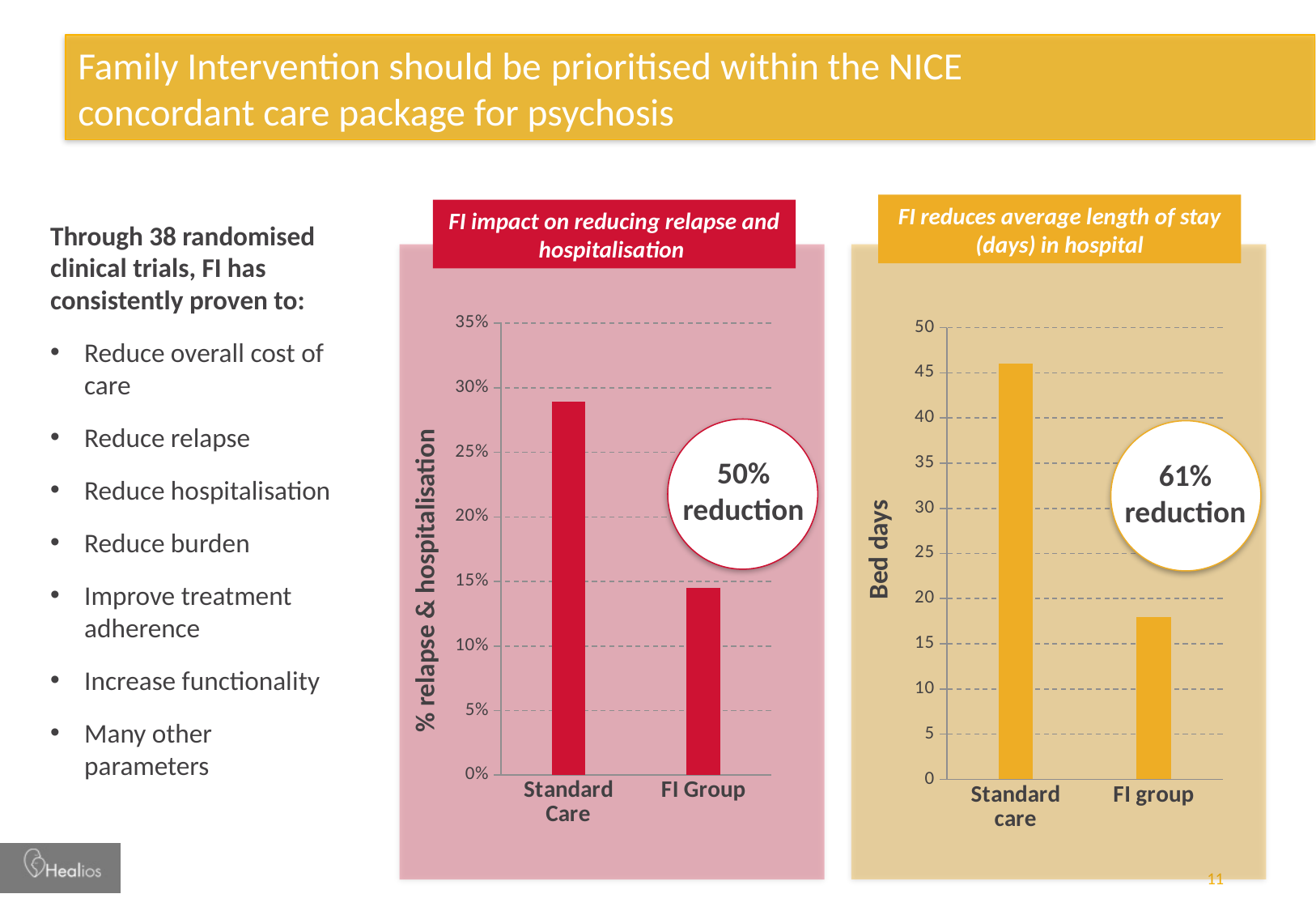
In the chart titled 'FI impact on reducing relapse and hospitalisation', is the value for FI Group greater or less than 20%? less In the chart titled 'FI impact on reducing relapse and hospitalisation', how many categories are plotted? 2 What kind of chart is the one titled 'FI impact on reducing relapse and hospitalisation'? bar chart What is the y-axis label of the chart titled 'FI reduces average length of stay (days) in hospital'? Bed days In the chart titled 'FI impact on reducing relapse and hospitalisation', is the value for Standard Care greater or less than 25%? greater In the chart titled 'FI reduces average length of stay (days) in hospital', is the value for Standard care greater or less than 40? greater In the chart titled 'FI reduces average length of stay (days) in hospital', which category has the higher value? Standard care In the chart titled 'FI impact on reducing relapse and hospitalisation', which category has the lower value? FI Group In the chart titled 'FI impact on reducing relapse and hospitalisation', which category has the higher value? Standard Care What is the y-axis label of the chart titled 'FI impact on reducing relapse and hospitalisation'? % relapse & hospitalisation In the chart titled 'FI reduces average length of stay (days) in hospital', is the value for Standard care or FI group larger? Standard care